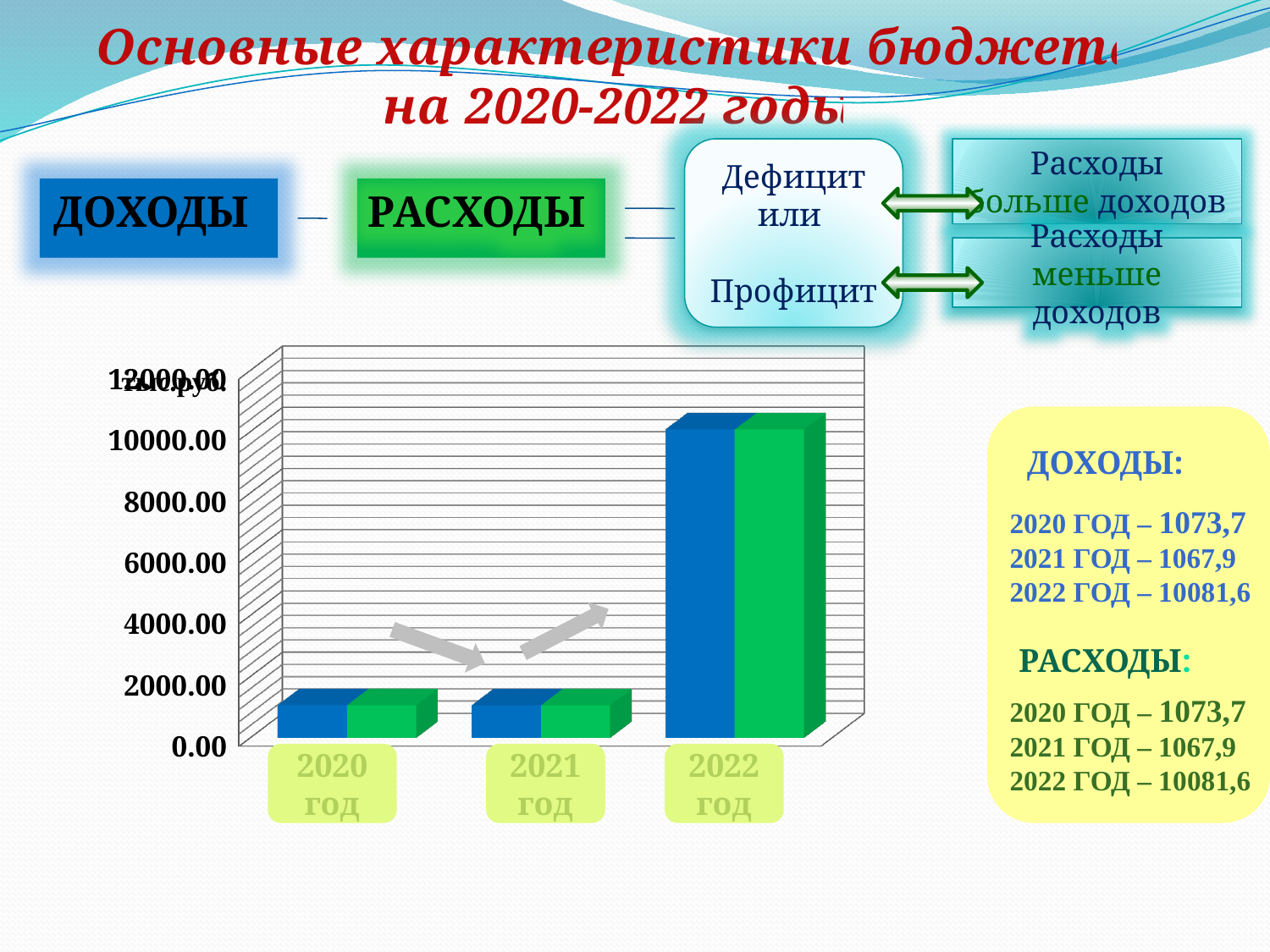
According to the slide, what is the value of РАСХОДЫ for 2020 год? 1073,7 Is the value for 2022 год greater or less than 8000.00? greater Is the value for 2021 год greater or less than 4000.00? less What type of chart is shown on the slide? bar chart Is the value for 2020 год greater or less than 2000.00? less According to the slide, what is the value of ДОХОДЫ for 2022 год? 10081,6 What unit is written at the top of the vertical axis of the chart? тыс.руб. How many year categories are shown on the x axis of the chart? 3 Which year has the highest bars in the chart? 2022 год How many bars are shown for each year category in the chart? 2 Which is larger, the value for 2021 год or the value for 2022 год? 2022 год Do the values rise or fall from 2021 год to 2022 год? rise